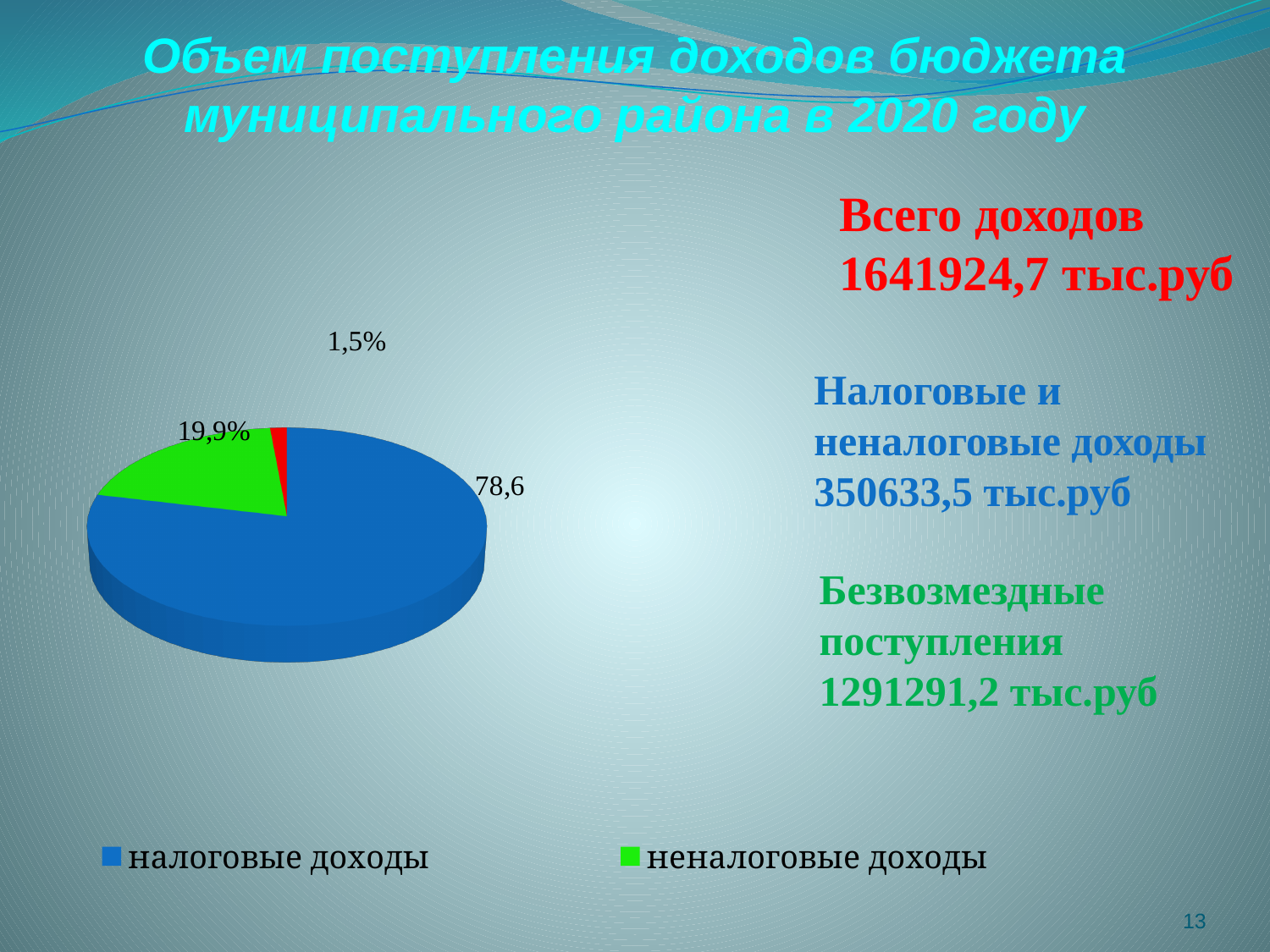
Which category has the largest slice of the pie? налоговые доходы What is the smallest value labelled on the pie chart? 1,5% How many entries does the legend list? 2 What kind of chart is shown on the slide? pie chart How many slices does the pie chart have? 3 What colour is the slice for налоговые доходы? blue What share of the pie is labelled for налоговые доходы? 78,6 What share of the pie is labelled for неналоговые доходы? 19,9% What colour is the slice for неналоговые доходы? green What is the difference between the labelled values for налоговые доходы and неналоговые доходы? 58,7 Which is larger, the slice for налоговые доходы or the slice for неналоговые доходы? налоговые доходы